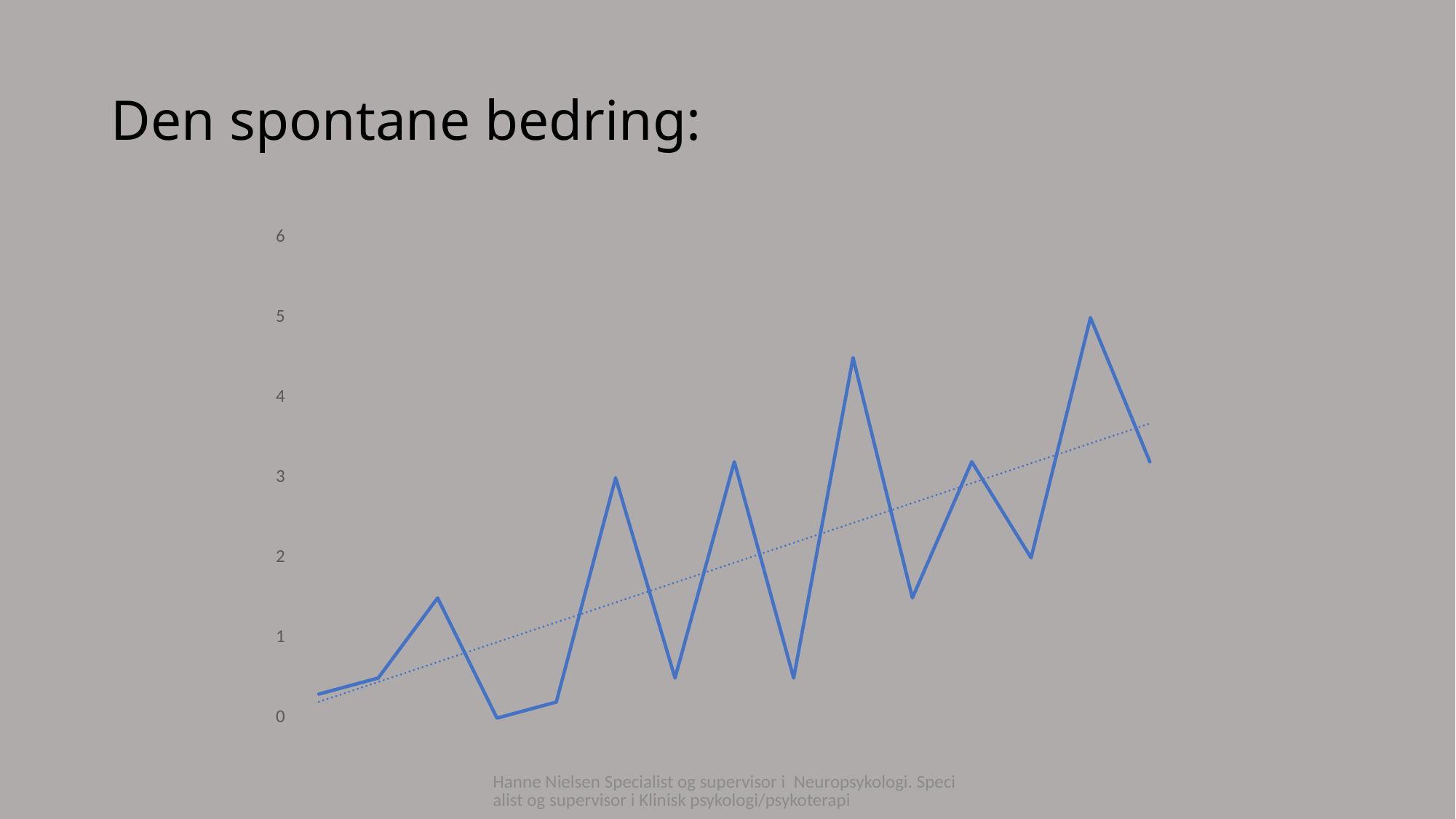
What colour is the plotted line? blue Is the final point of the solid line higher or lower than its highest peak? lower Is the first point of the solid line greater or less than 1? less Is the lowest point of the solid line greater or less than 1? less Does the dotted trend line on the chart rise or fall from left to right? rise What kind of chart is shown on the slide? line chart How many data points does the solid line have? 15 What is the lowest value reached by the solid line? 0 Is the highest point of the solid line greater or less than 4? greater Overall, do the values of the solid line rise or fall along the x axis? rise What is the highest value shown on the y axis? 6